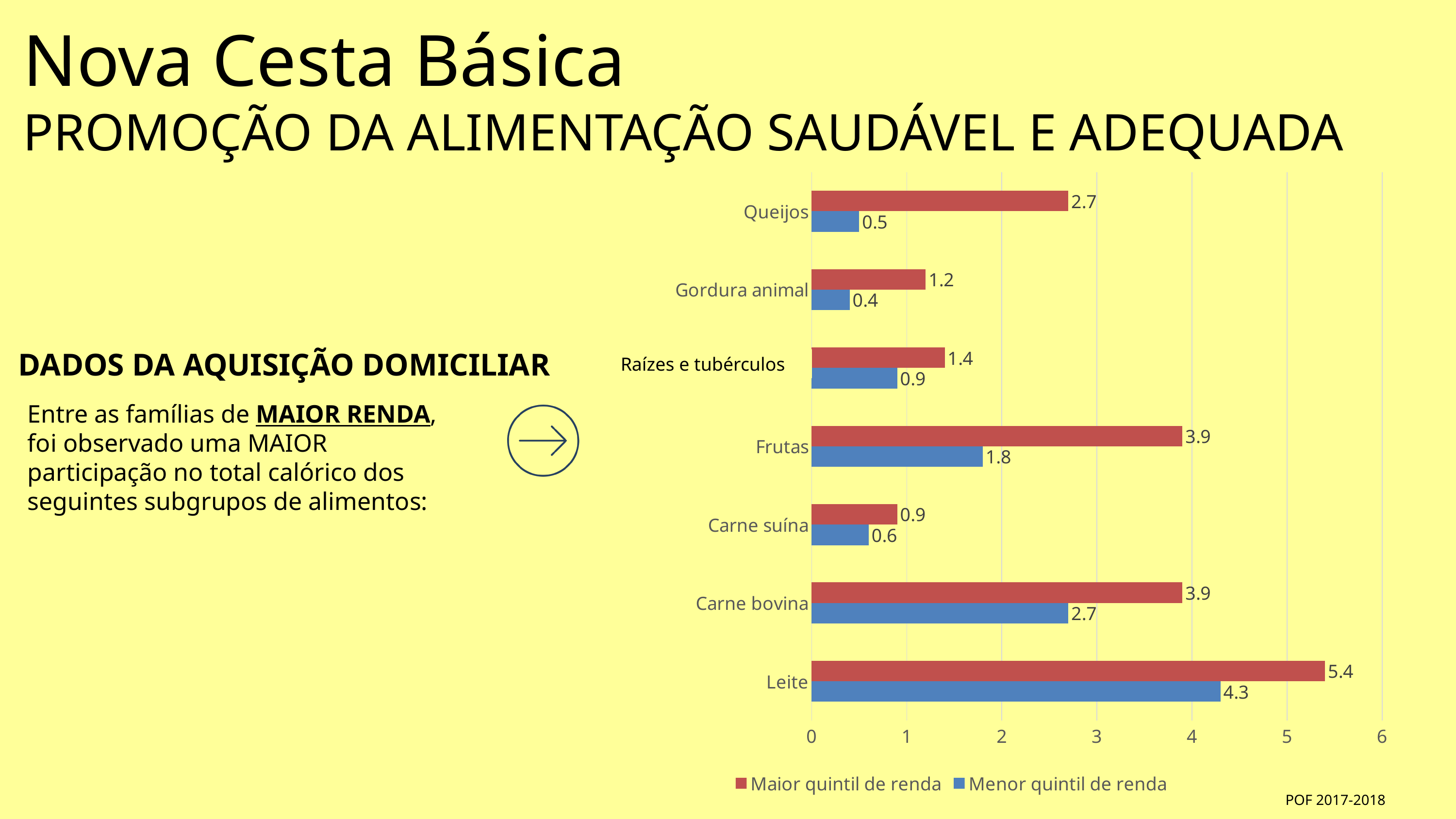
How many food categories are shown on the chart? 7 What is the value for Leite in the Maior quintil de renda series? 5.4 How many series does the legend list? 2 Which category has the highest value in the Maior quintil de renda series? Leite What kind of chart is shown on the slide? Bar chart What is the value for Queijos in the Menor quintil de renda series? 0.5 Which is larger for Carne suína: the Maior quintil de renda value or the Menor quintil de renda value? Maior quintil de renda Which colour represents the Menor quintil de renda series? Blue What is the difference between the Maior quintil de renda and Menor quintil de renda values for Carne bovina? 1.2 What is the difference between the Maior quintil de renda and Menor quintil de renda values for Queijos? 2.2 What is the value for Frutas in the Menor quintil de renda series? 1.8 Which category has the lowest value in the Menor quintil de renda series? Gordura animal